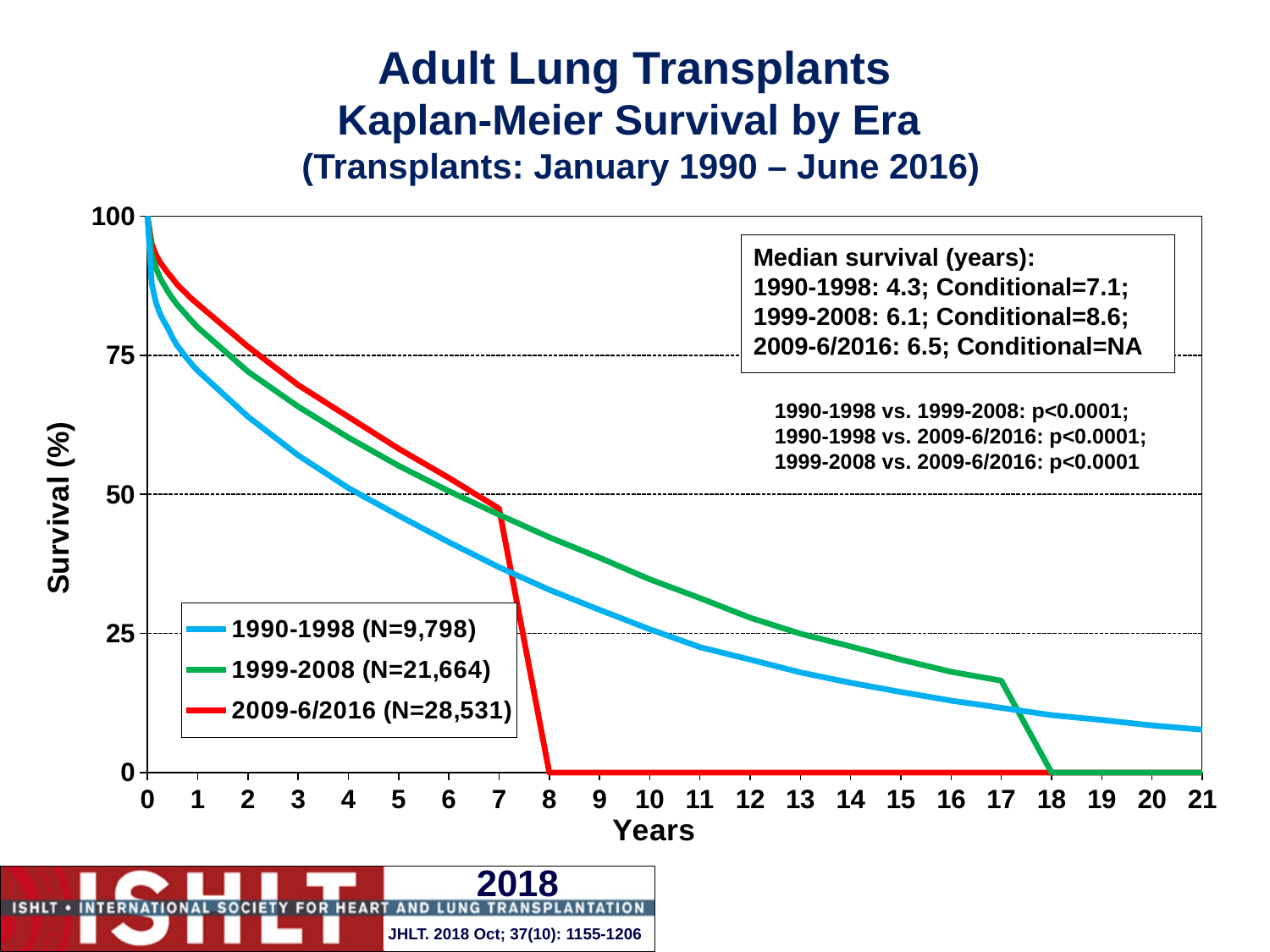
Which era has the highest median survival? 2009-6/2016 What is the conditional median survival in years for the 1999-2008 era? 8.6 How many series does the legend list? 3 What is the N shown in the legend for the 2009-6/2016 era? 28,531 What is the difference in median survival (years) between the 1999-2008 era and the 1990-1998 era? 1.8 What kind of chart is shown on the slide? line chart At 10 years, which era has higher survival, 1990-1998 or 1999-2008? 1999-2008 Is the survival for the 1999-2008 era at 10 years greater or less than 25? greater Which era has the lowest median survival? 1990-1998 Do the survival curves rise or fall as years increase? fall Is the survival for the 1990-1998 era at 5 years greater or less than 50? less What is the median survival in years for the 1990-1998 era? 4.3